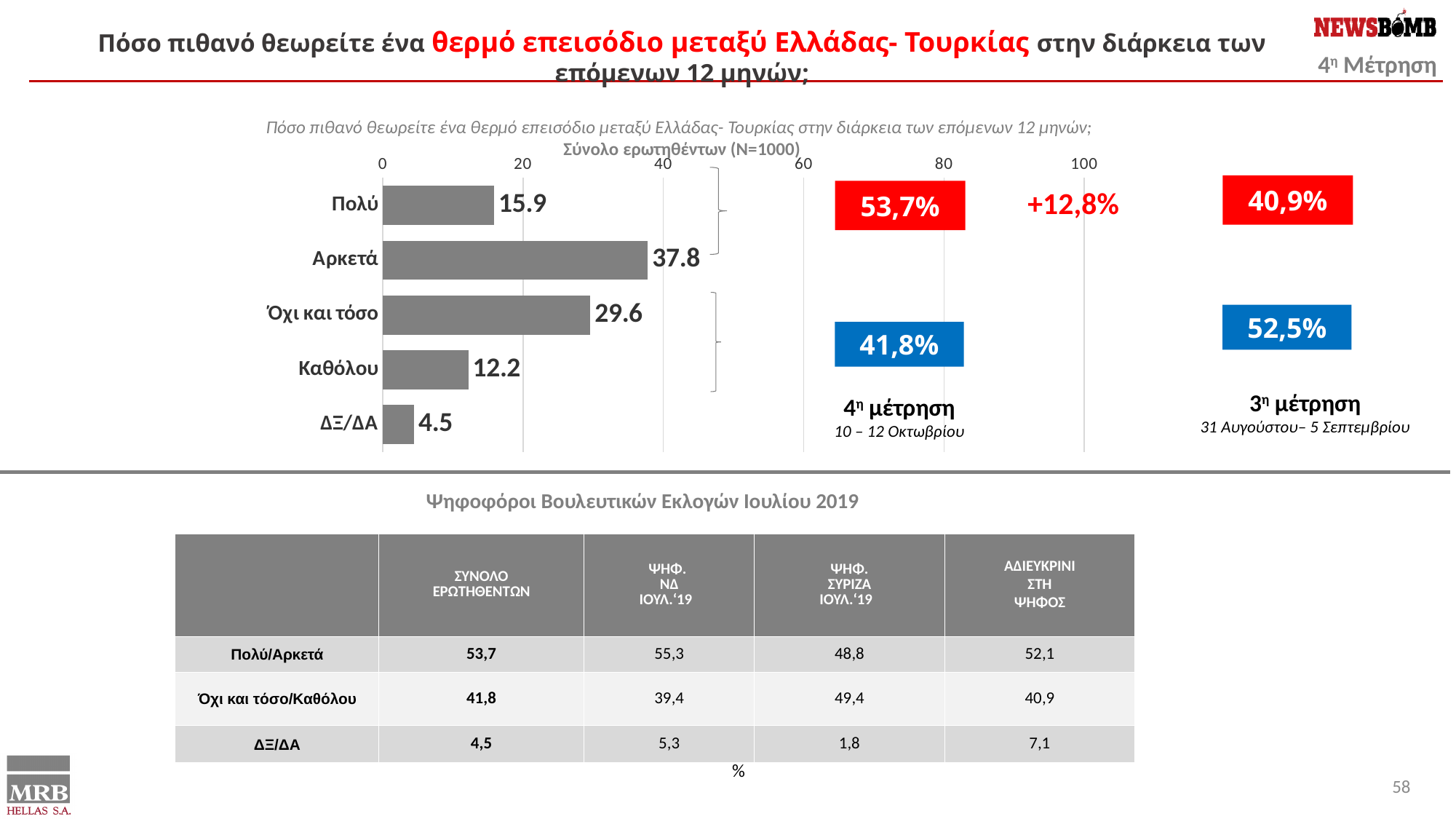
How many categories are shown in the bar chart? 5 Which is larger in the bar chart, the value for Πολύ or the value for Καθόλου? Πολύ Which category has the highest value in the bar chart? Αρκετά Is the value for Αρκετά greater or less than 40? less What kind of chart is shown on the slide? bar chart Which category has the lowest value in the bar chart? ΔΞ/ΔΑ What is the value for Όχι και τόσο in the bar chart? 29.6 What is the total of the values for Πολύ and Αρκετά in the bar chart? 53.7 What is the difference between the values for Αρκετά and Όχι και τόσο? 8.2 What is the value for Πολύ in the bar chart? 15.9 What is the value for Αρκετά in the bar chart? 37.8 What is the value for ΔΞ/ΔΑ in the bar chart? 4.5